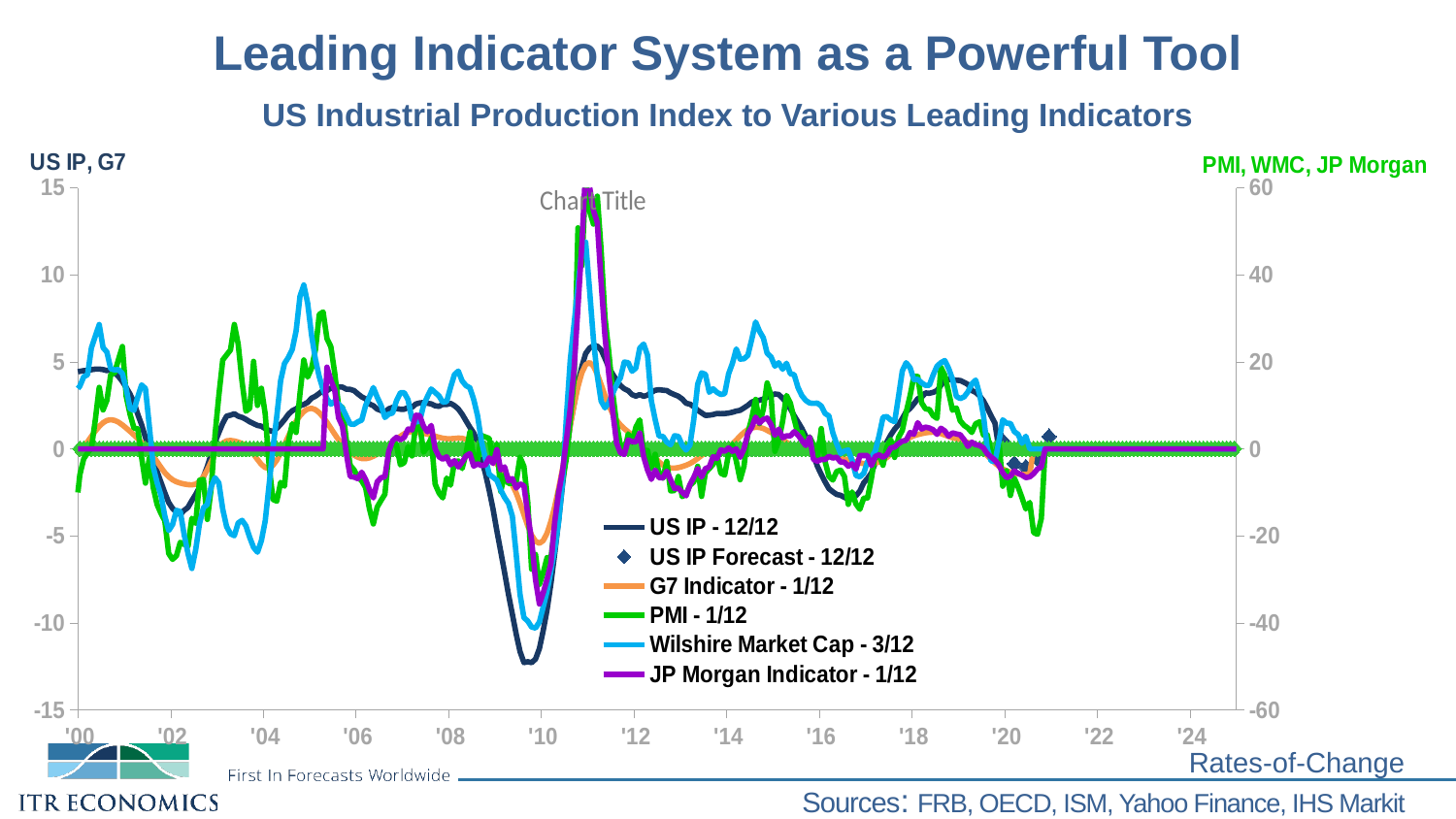
What is the subtitle of the chart on the slide? US Industrial Production Index to Various Leading Indicators Is the lowest value of the PMI - 1/12 line around 2009 greater or less than -20 on the right axis? less Does the JP Morgan Indicator - 1/12 line rise or fall between 2009 and 2011? rise What kind of chart is shown on the slide? line chart Does the US IP - 12/12 line rise or fall between 2008 and 2009? fall Is the lowest value of the US IP - 12/12 line, around 2009-2010, greater or less than -10? less How many year labels are shown along the x axis? 13 Is the peak of the Wilshire Market Cap - 3/12 line around 2005 greater or less than 20 on the right axis? greater Which series in the legend is shown as diamond markers rather than a line? US IP Forecast - 12/12 How many series does the legend list? 6 Which series are plotted on the right-hand axis, according to the axis label? PMI, WMC, JP Morgan